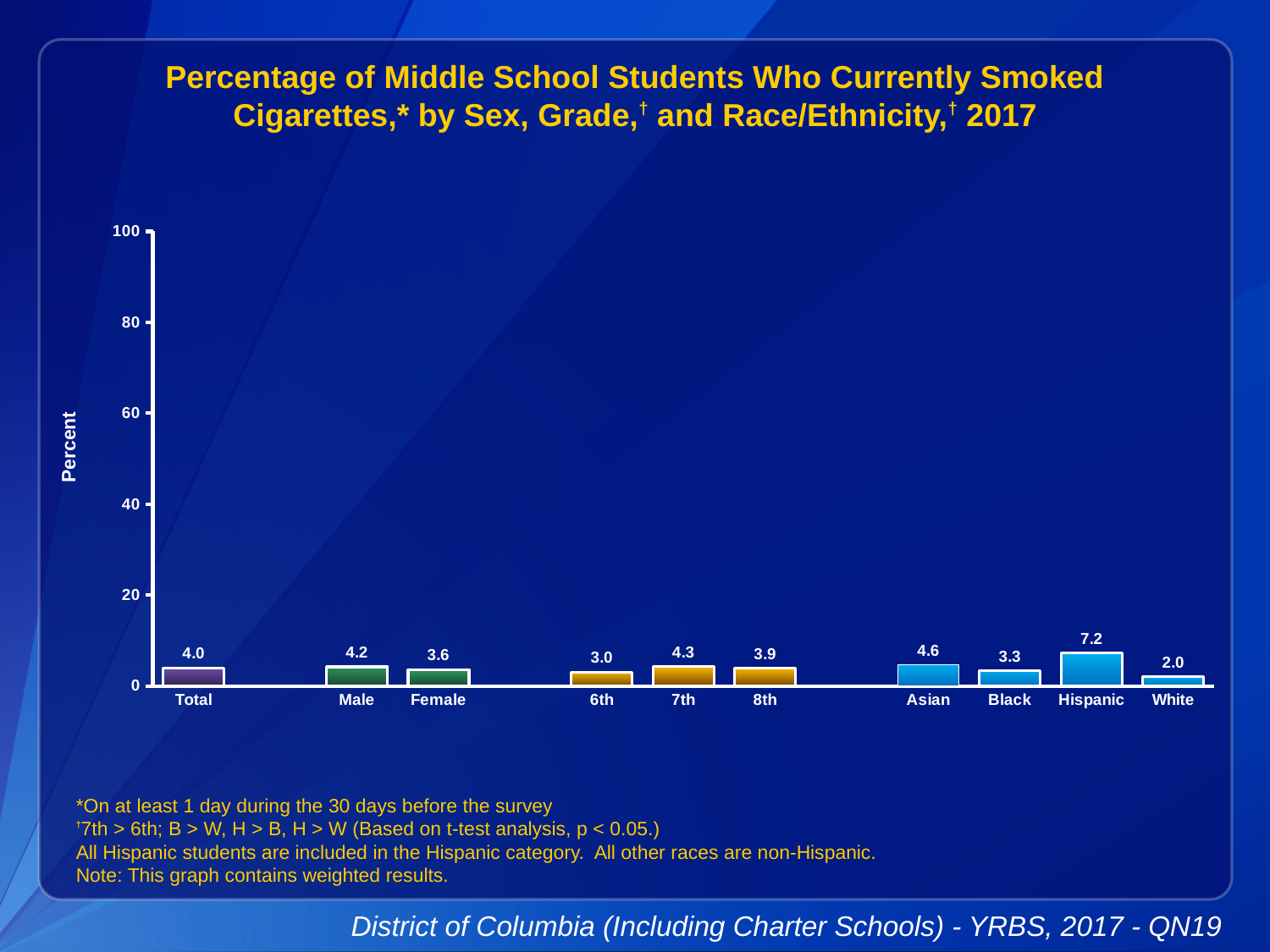
Which is larger, the value for 7th grade or 8th grade? 7th What is the label on the y axis? Percent How many categories are shown on the x axis? 10 What is the difference between the Male and Female values? 0.6 What is the value for Total? 4.0 What is the value for Hispanic students? 7.2 Is the value for Asian students greater or less than 20? less Which category has the highest value? Hispanic What is the difference between the Hispanic and White values? 5.2 Which category has the lowest value? White What is the value for 6th grade? 3.0 What kind of chart is this? bar chart